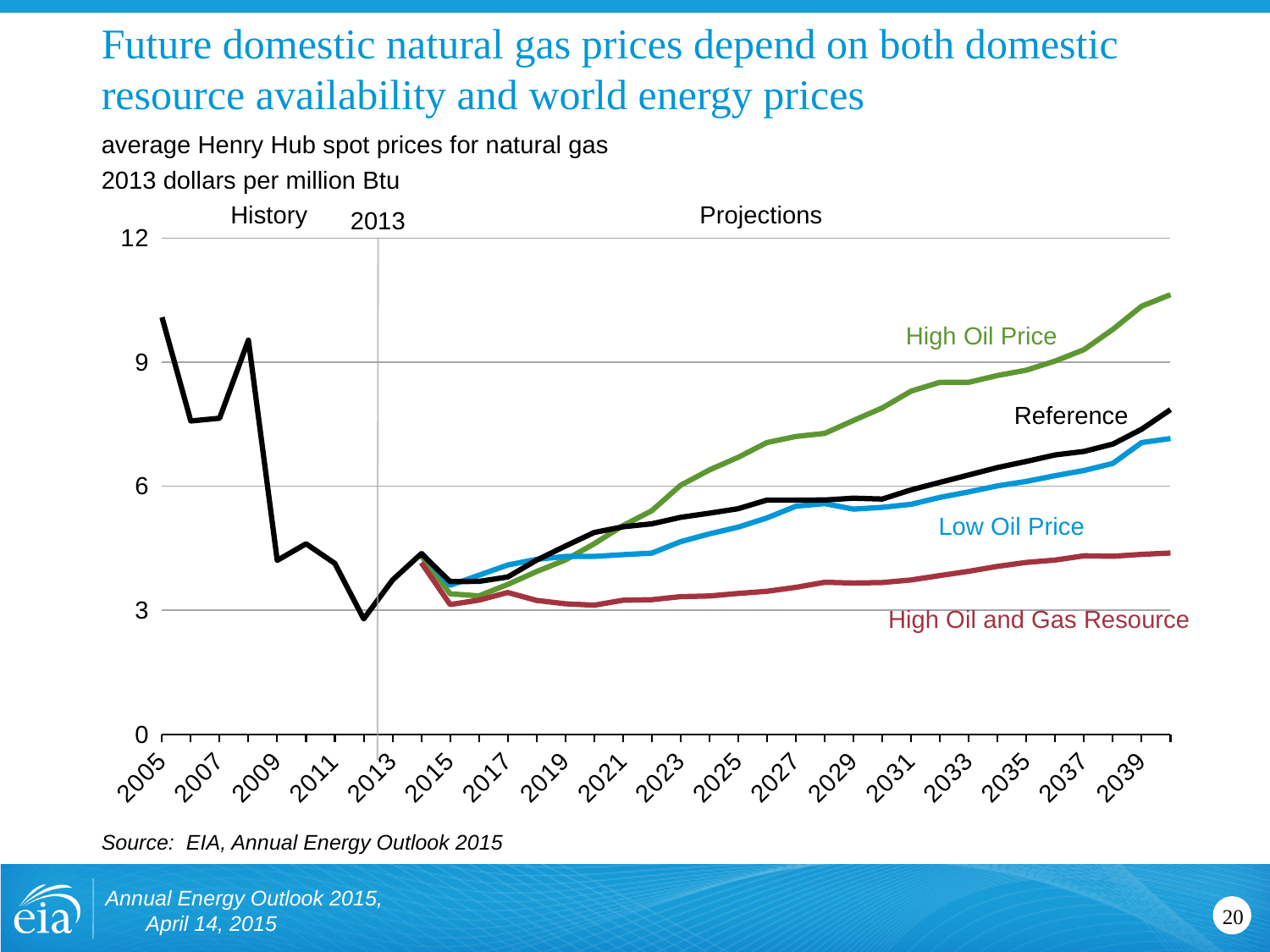
What kind of chart is shown on the slide? line chart Which series has the lowest value in 2040? High Oil and Gas Resource Is the historical value in 2005 greater or less than 9? greater In 2030, which is higher: the High Oil Price series or the Reference series? High Oil Price Is the Reference value in 2040 greater or less than 6? greater Is the High Oil Price value in 2040 greater or less than 9? greater In 2040, which is higher: the Reference series or the Low Oil Price series? Reference How many price scenario series are plotted on the chart? 4 What unit is the price measured in, according to the chart subtitle? 2013 dollars per million Btu Which series has the highest value in 2040? High Oil Price Does the High Oil Price series rise or fall between 2015 and 2040? rise